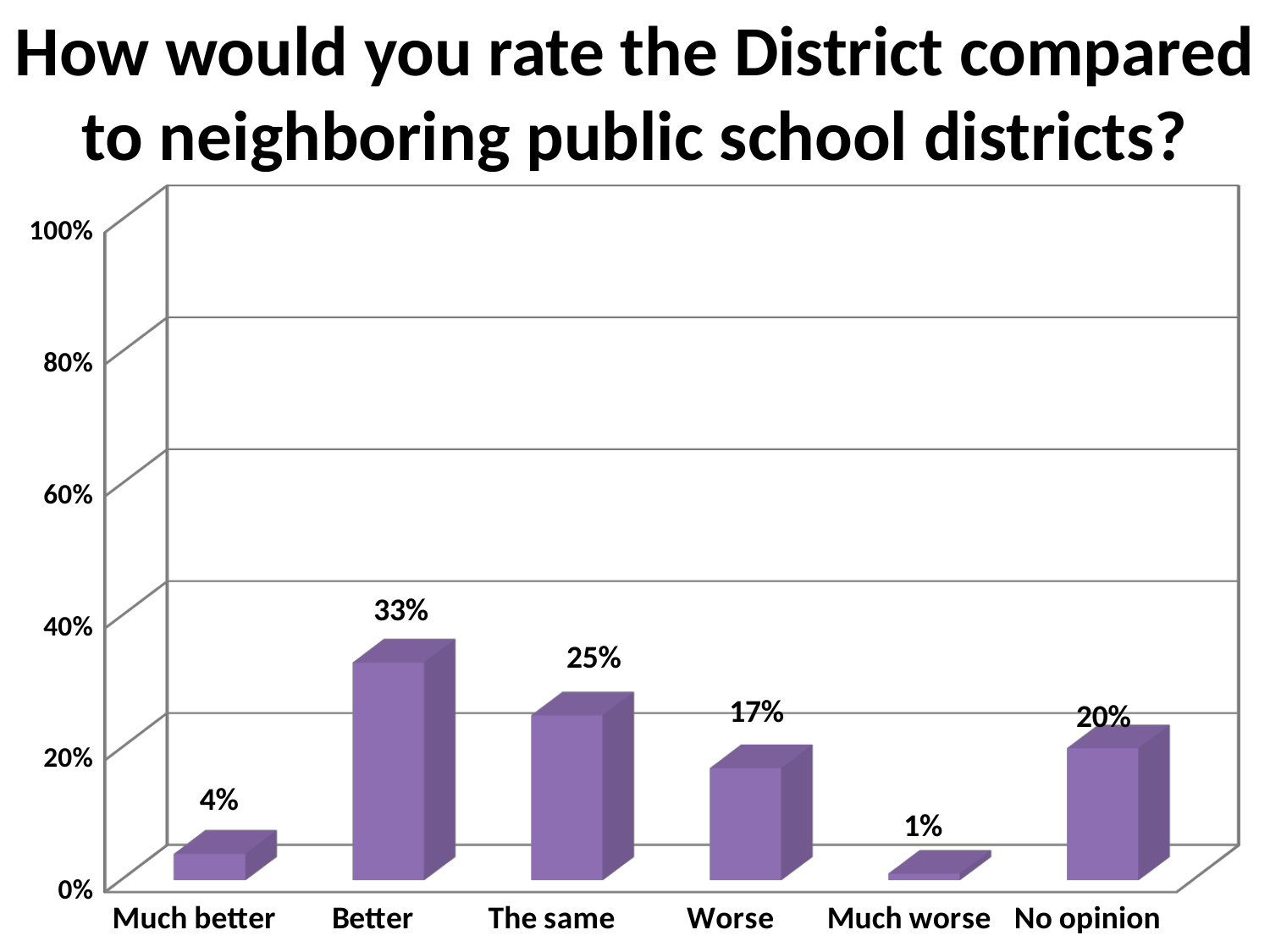
How many response categories are shown on the x axis? 6 What is the difference between the values for "No opinion" and "Worse"? 3% What kind of chart is shown on the slide? Bar chart Is the value for "Better" greater or less than 40%? less What percentage of respondents chose "Much worse"? 1% Which response category has the highest value? Better Which is larger, the value for "The same" or the value for "No opinion"? The same What is the title of the chart? How would you rate the District compared to neighboring public school districts? What is the difference between the values for "Better" and "The same"? 8% Which response category has the lowest value? Much worse What is the value shown for "No opinion"? 20% What percentage of respondents rated the District as "Better" than neighboring public school districts? 33%